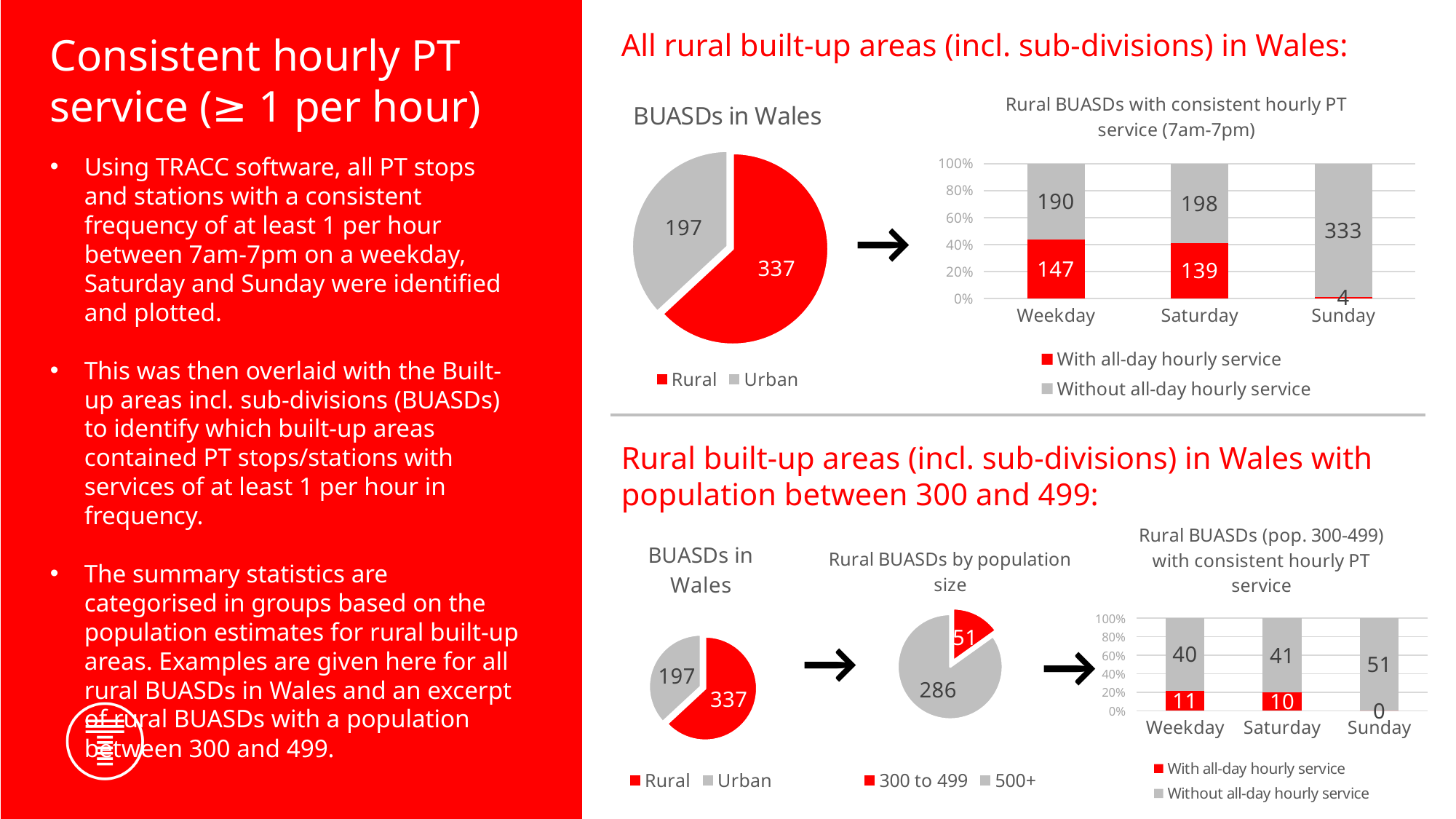
In the top pie chart titled 'BUASDs in Wales', what is the difference between the Rural and Urban values? 140 In the chart titled 'Rural BUASDs with consistent hourly PT service (7am-7pm)', what is the value for 'With all-day hourly service' on Saturday? 139 In the chart titled 'Rural BUASDs with consistent hourly PT service (7am-7pm)', what is the total of the two segments in the Weekday bar? 337 In the chart titled 'Rural BUASDs with consistent hourly PT service (7am-7pm)', what is the value for 'Without all-day hourly service' on Sunday? 333 In the top pie chart titled 'BUASDs in Wales', what is the value for Urban? 197 In the chart titled 'Rural BUASDs with consistent hourly PT service (7am-7pm)', which day has the lowest value for 'With all-day hourly service'? Sunday In the chart titled 'Rural BUASDs (pop. 300-499) with consistent hourly PT service', what is the value for 'With all-day hourly service' on Weekday? 11 In the chart titled 'Rural BUASDs by population size', what is the value for '300 to 499'? 51 In the chart titled 'Rural BUASDs with consistent hourly PT service (7am-7pm)', how many series does the legend list? 2 In the top pie chart titled 'BUASDs in Wales', what is the value for Rural? 337 In the chart titled 'Rural BUASDs by population size', which category is larger, '300 to 499' or '500+'? 500+ What kind of chart is 'Rural BUASDs (pop. 300-499) with consistent hourly PT service'? Stacked bar chart